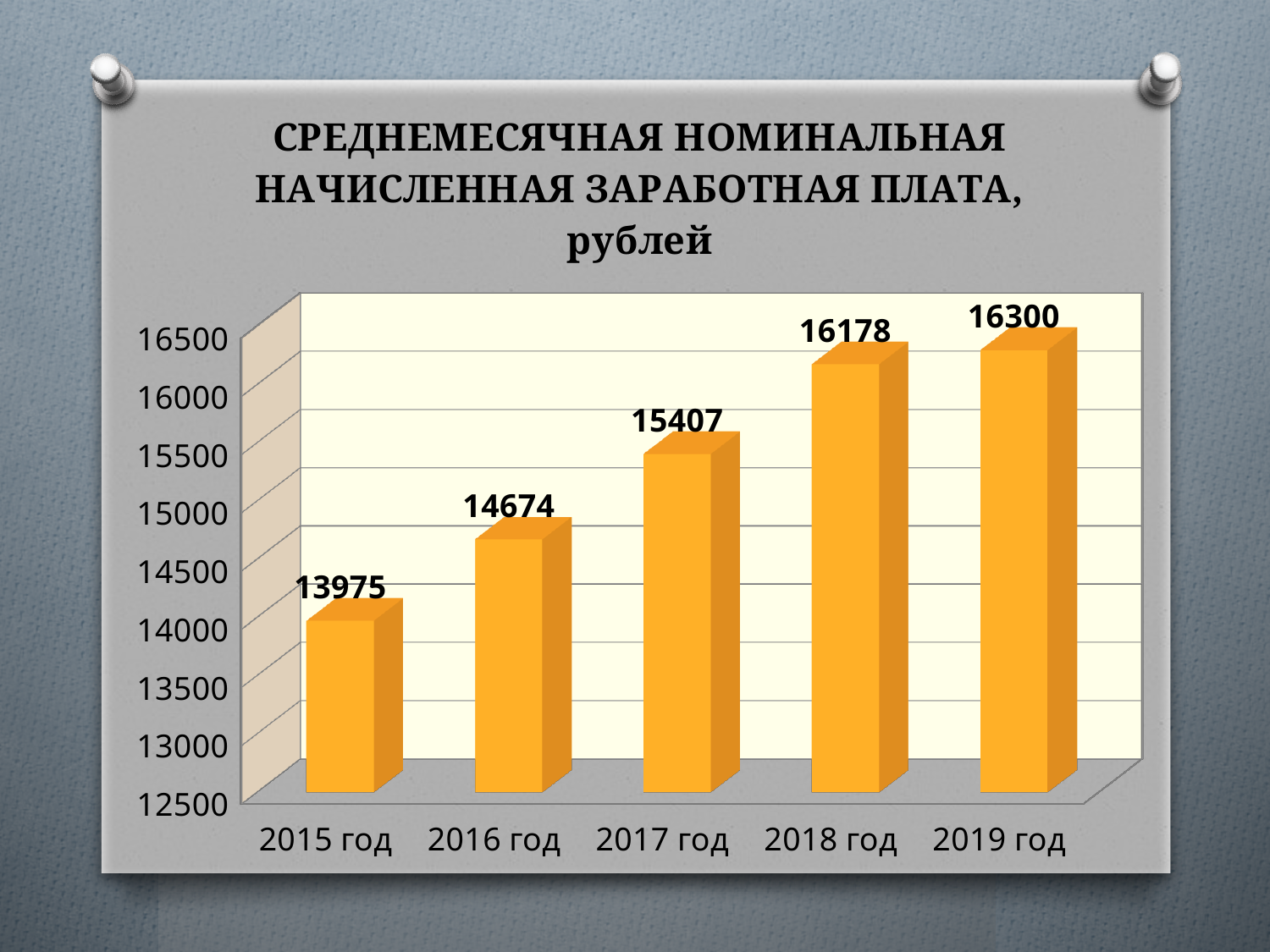
How many years are shown on the chart? 5 Which is larger, the value for 2017 год or the value for 2018 год? 2018 год What is the value for 2019 год? 16300 What is the value for 2015 год? 13975 What is the value for 2017 год? 15407 What kind of chart is shown on the slide? bar chart Which year has the lowest value? 2015 год Which year has the highest value? 2019 год Is the value for 2016 год greater or less than 15000? less What is the difference between the values for 2016 год and 2015 год? 699 Do the values rise or fall from 2015 год to 2019 год? rise What is the difference between the values for 2019 год and 2018 год? 122